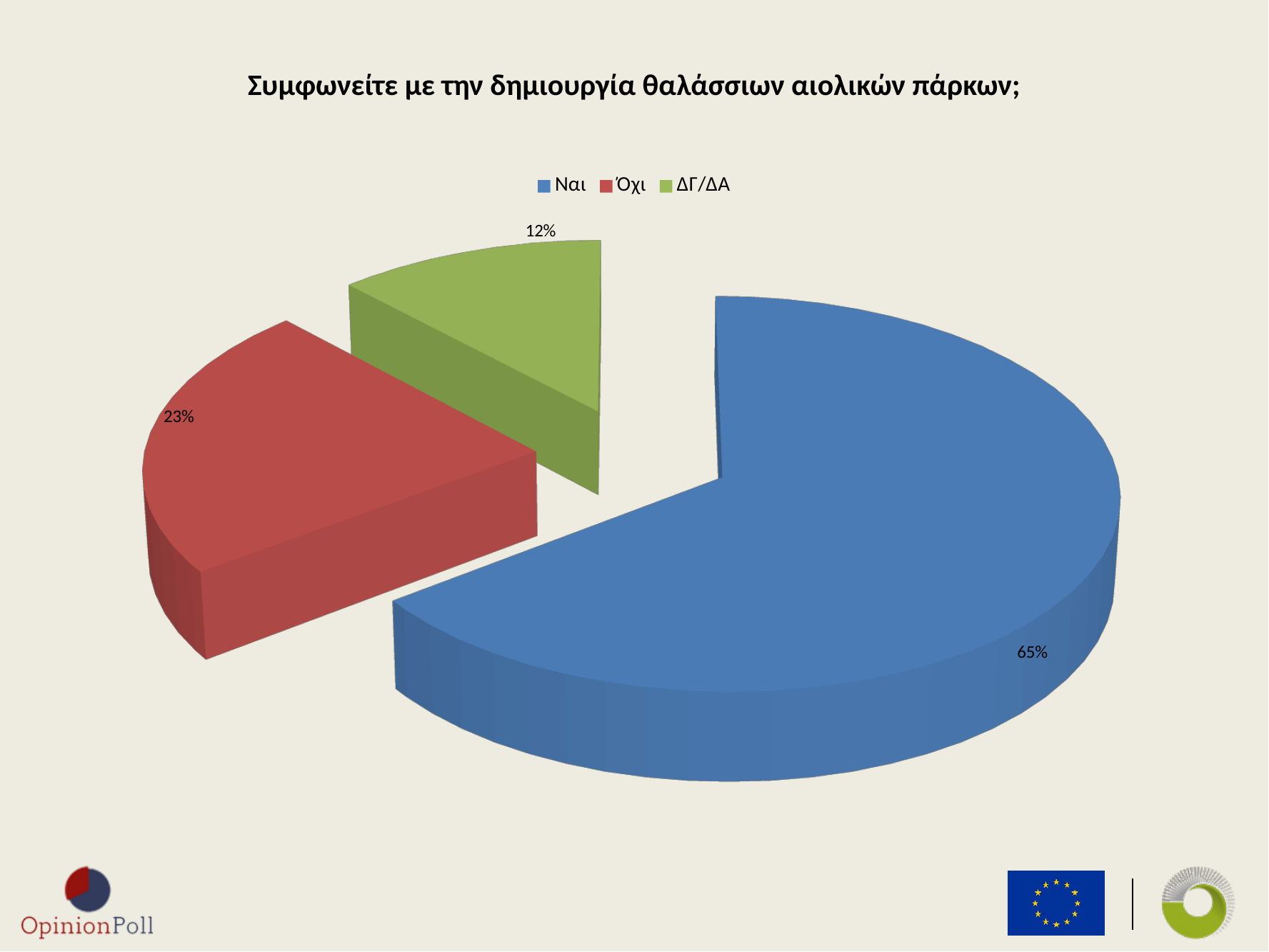
Which response has the smallest share of the pie? ΔΓ/ΔΑ What percentage of respondents answered Ναι? 65% How many slices does the pie chart have? 3 How many entries does the legend list? 3 What is the difference in percentage points between Ναι and Όχι? 42 What is the difference in percentage points between Όχι and ΔΓ/ΔΑ? 11 What colour is the slice for Όχι? Red What kind of chart is shown on the slide? Pie chart Which is larger, the share for Όχι or the share for ΔΓ/ΔΑ? Όχι Which response has the largest share of the pie? Ναι What percentage of respondents answered Όχι? 23% What percentage of respondents answered ΔΓ/ΔΑ? 12%